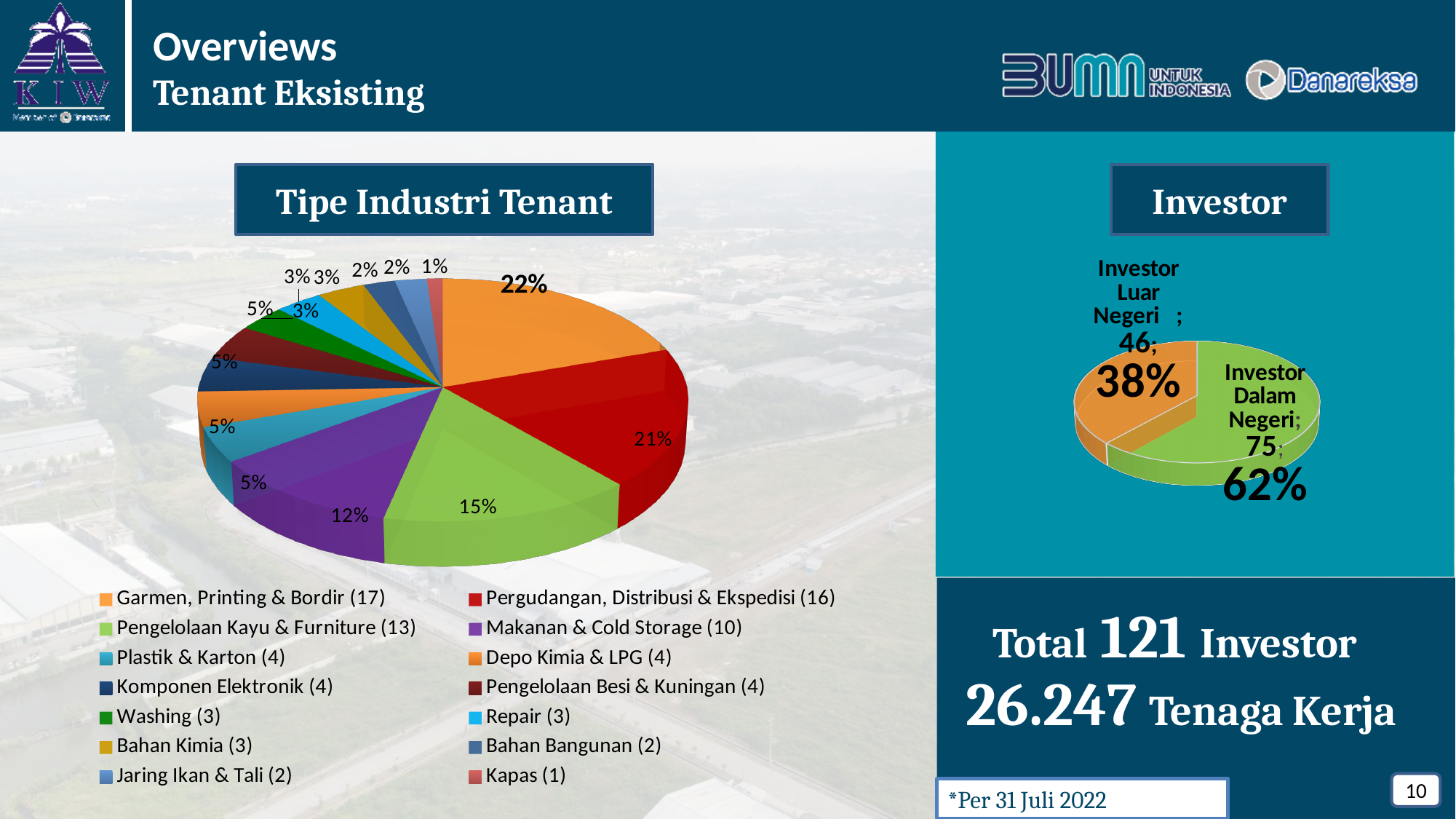
In the "Tipe Industri Tenant" chart, which category has the largest share? Garmen, Printing & Bordir In the "Tipe Industri Tenant" chart, what percentage share does Pengelolaan Kayu & Furniture have? 15% In the "Investor" chart, how many Investor Luar Negeri are there? 46 In the "Investor" chart, what percentage share is Investor Dalam Negeri? 62% In the "Investor" chart, what is the difference between the number of Investor Dalam Negeri (75) and Investor Luar Negeri (46)? 29 In the "Tipe Industri Tenant" chart, how many tenants are in the Makanan & Cold Storage category according to the legend? 10 In the "Investor" chart, what colour is the Investor Luar Negeri slice? orange In the "Tipe Industri Tenant" chart, what is the difference in tenant count between Garmen, Printing & Bordir (17) and Pergudangan, Distribusi & Ekspedisi (16)? 1 What type of chart is the "Tipe Industri Tenant" chart? pie chart In the "Tipe Industri Tenant" chart, how many categories does the legend list? 14 In the "Tipe Industri Tenant" chart, which category has the smallest share? Kapas In the "Tipe Industri Tenant" chart, which has more tenants: Washing or Bahan Bangunan? Washing